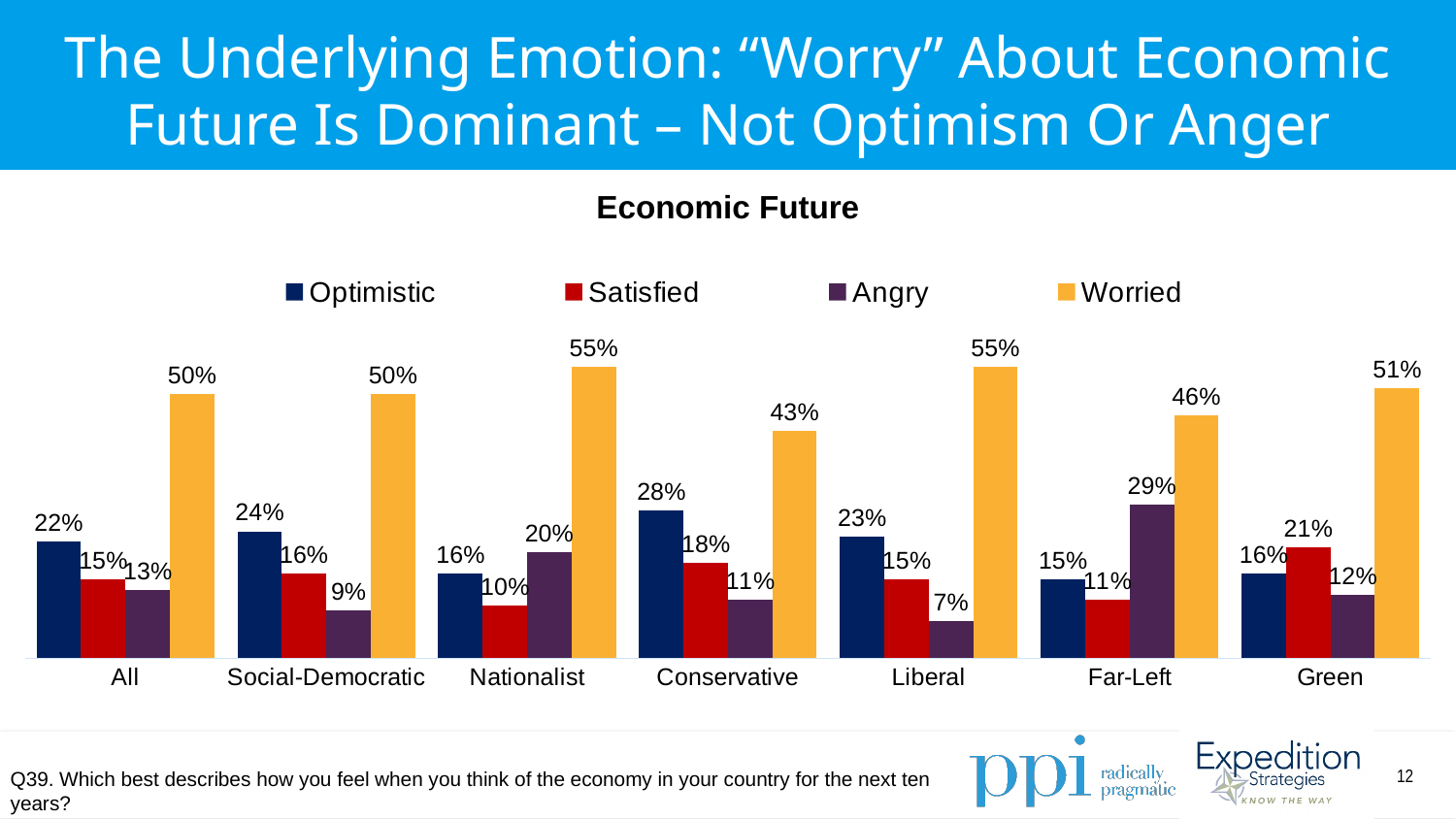
Which category has the highest Optimistic value? Conservative What is the title of the chart? Economic Future Which category has the lowest Worried value? Conservative What is the Angry value for Far-Left? 29% What is the Optimistic value for the All category? 22% What is the difference between the Worried and Optimistic values for Nationalist? 39% How many series does the legend list? 4 How many categories are shown on the x axis? 7 What percentage of Conservative respondents are Worried about the economic future? 43% Which series is shown in yellow? Worried Which is larger for Green: Satisfied or Optimistic? Satisfied What kind of chart is shown? Bar chart